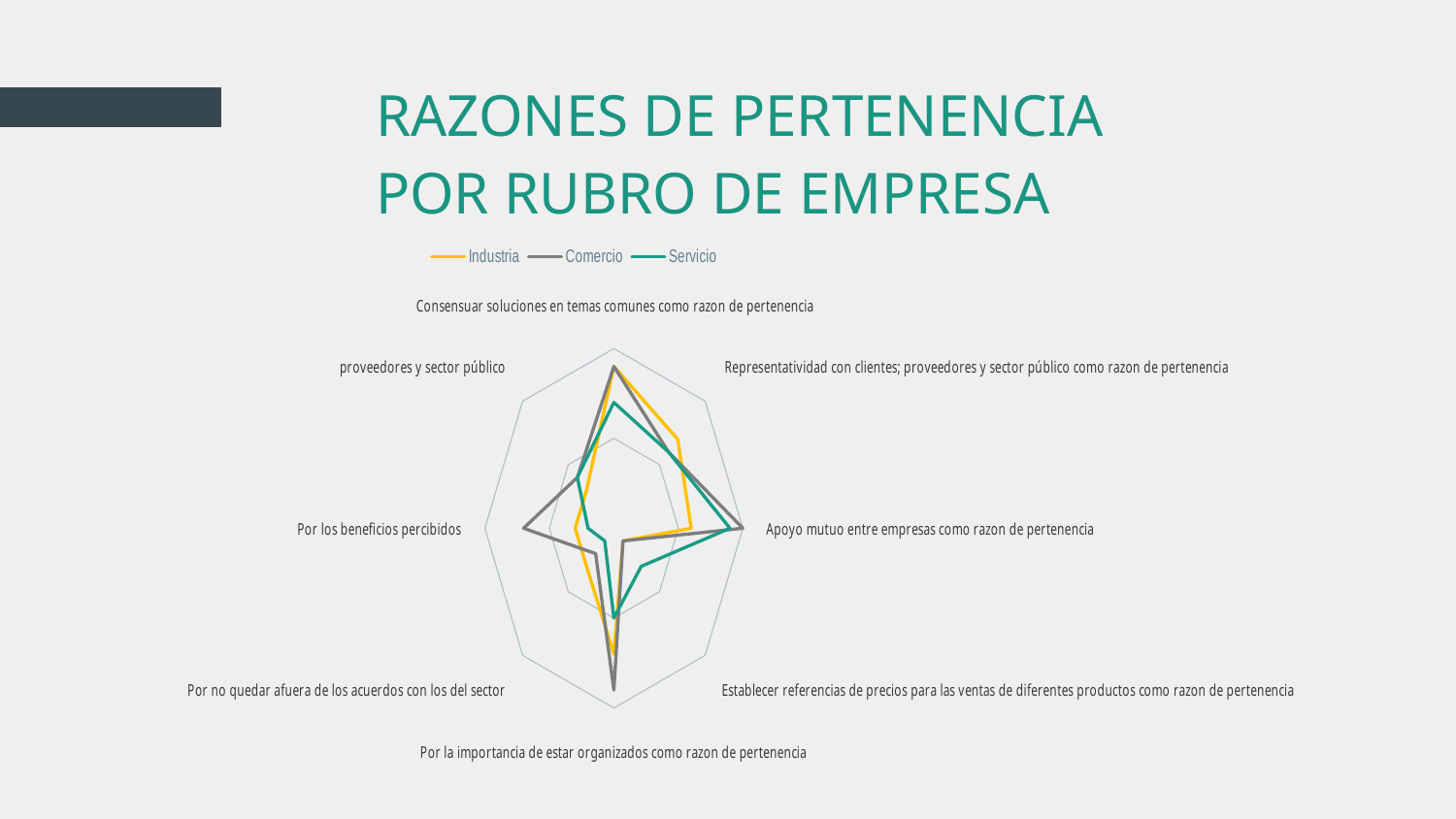
Which series has the highest value for 'Por los beneficios percibidos'? Comercio For 'Consensuar soluciones en temas comunes como razon de pertenencia', which is larger: Comercio or Servicio? Comercio What is the title of the chart on the slide? RAZONES DE PERTENENCIA POR RUBRO DE EMPRESA How many series does the legend list? 3 Which series are listed in the legend? Industria, Comercio, Servicio For 'Representatividad con clientes; proveedores y sector público como razon de pertenencia', which is larger: Industria or Servicio? Industria How many categories (axes) does the radar chart have? 8 Which series has the highest value for 'Establecer referencias de precios para las ventas de diferentes productos como razon de pertenencia'? Servicio For 'Apoyo mutuo entre empresas como razon de pertenencia', which is larger: Servicio or Industria? Servicio What kind of chart is shown on the slide? Radar chart